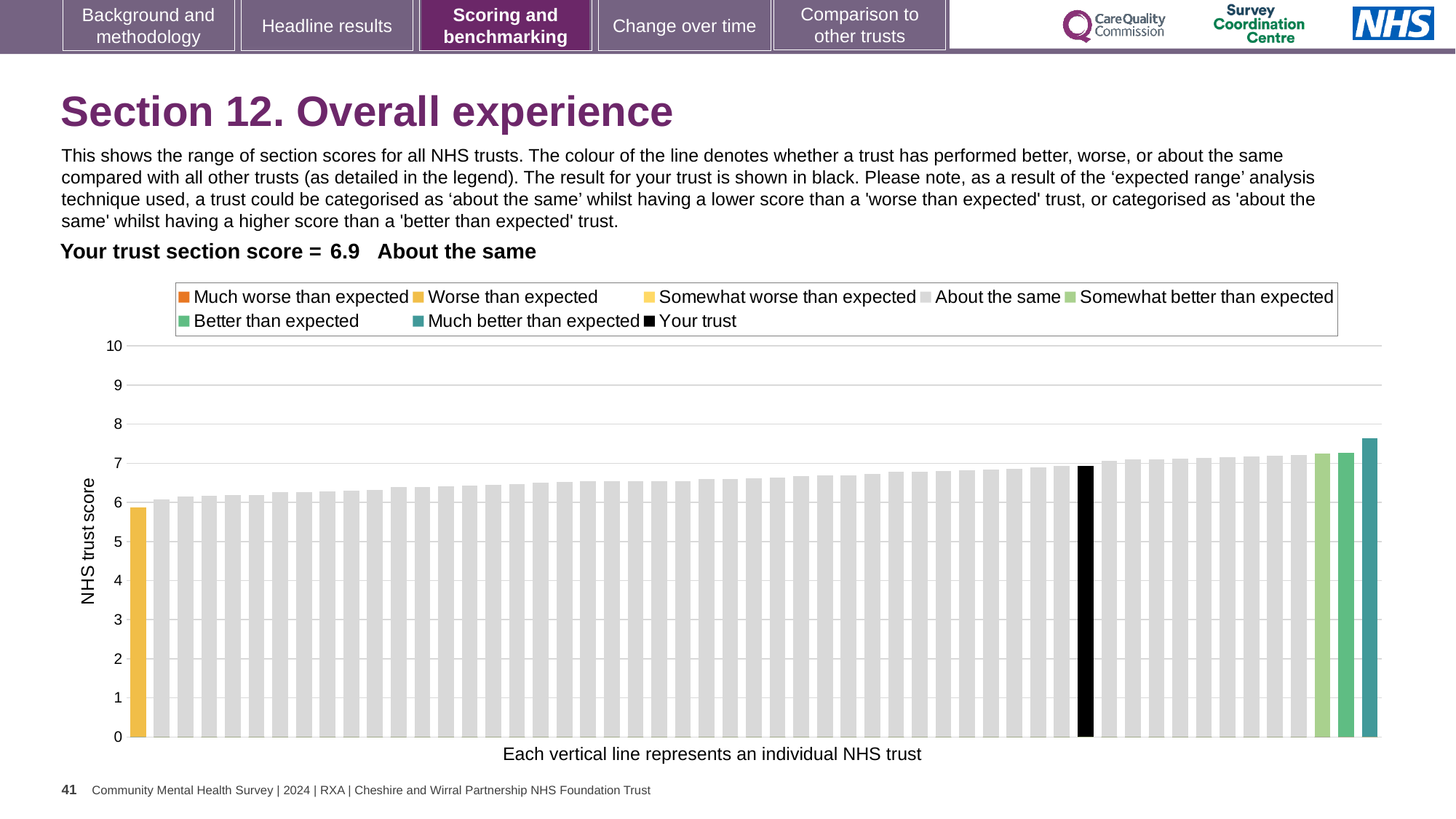
How many bars are coloured as 'Much better than expected'? 1 Do the bar values rise or fall from left to right along the x axis? rise Is the value for the lowest bar (the yellow 'Worse than expected' trust) greater or less than 6? less Which legend category does the lowest bar belong to? Worse than expected What is the section score for your trust shown on the slide? 6.9 Which legend category does the highest bar belong to? Much better than expected What kind of chart is shown on the slide? bar chart Is the value for your trust (the black bar) greater or less than 6? greater What is the label on the y axis of the chart? NHS trust score Is the value for the highest bar (the teal 'Much better than expected' trust) greater or less than 7? greater How many entries does the legend list? 8 How is your trust categorised compared with other trusts for this section? About the same